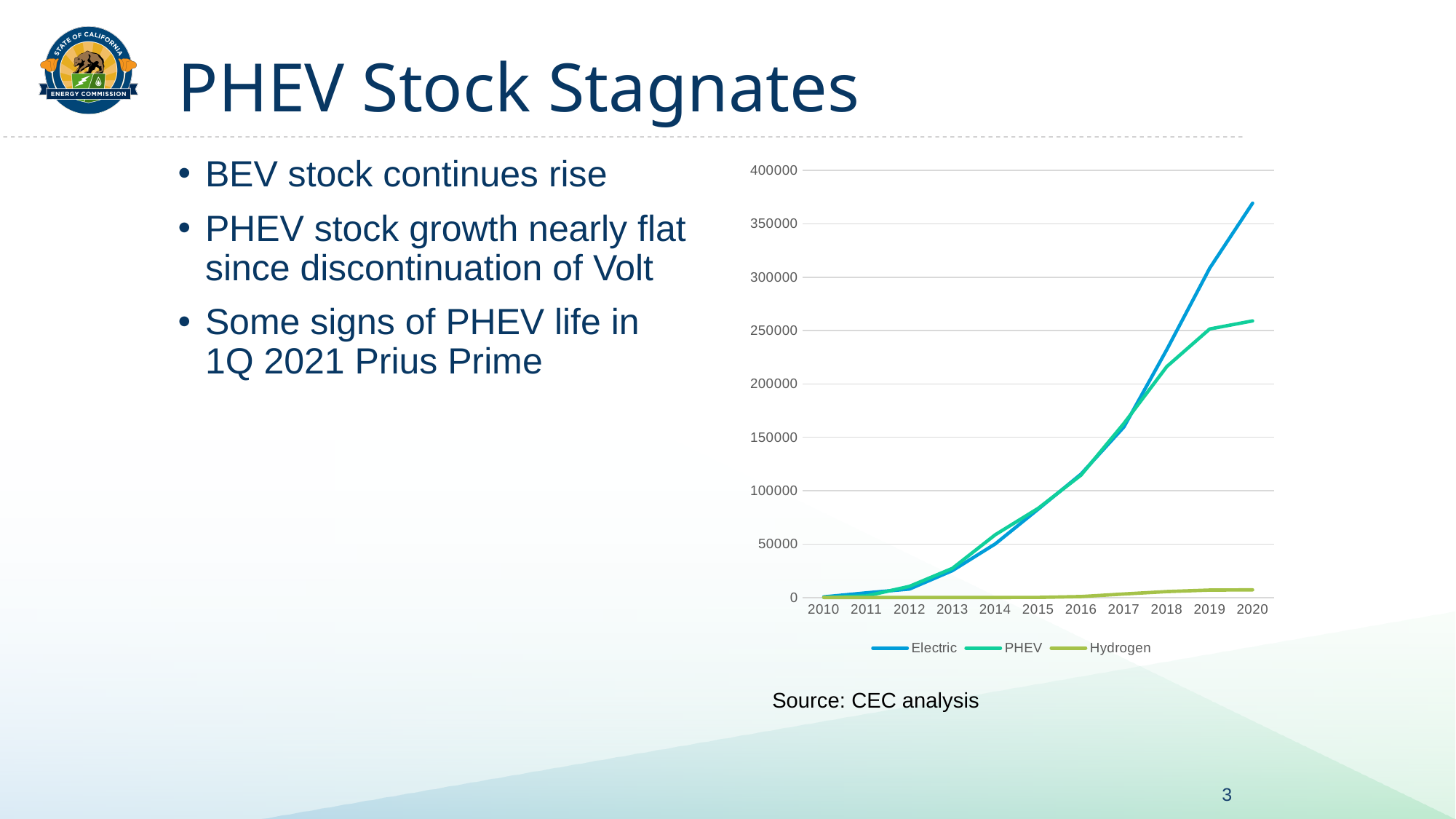
Is the value for Electric in 2015 greater or less than 100000? less Is the value for Hydrogen in 2020 greater or less than 50000? less Is the value for Electric in 2020 greater or less than 350000? greater Which series has the highest value in 2020? Electric How many years are shown along the x axis of the chart? 11 What are the three series named in the chart's legend? Electric, PHEV, Hydrogen How many series does the chart's legend list? 3 Which series has the lowest value in 2020? Hydrogen What kind of chart is shown on the slide? line chart Does the Electric series rise or fall from 2010 to 2020? rise In 2020, which is larger, the Electric value or the PHEV value? Electric